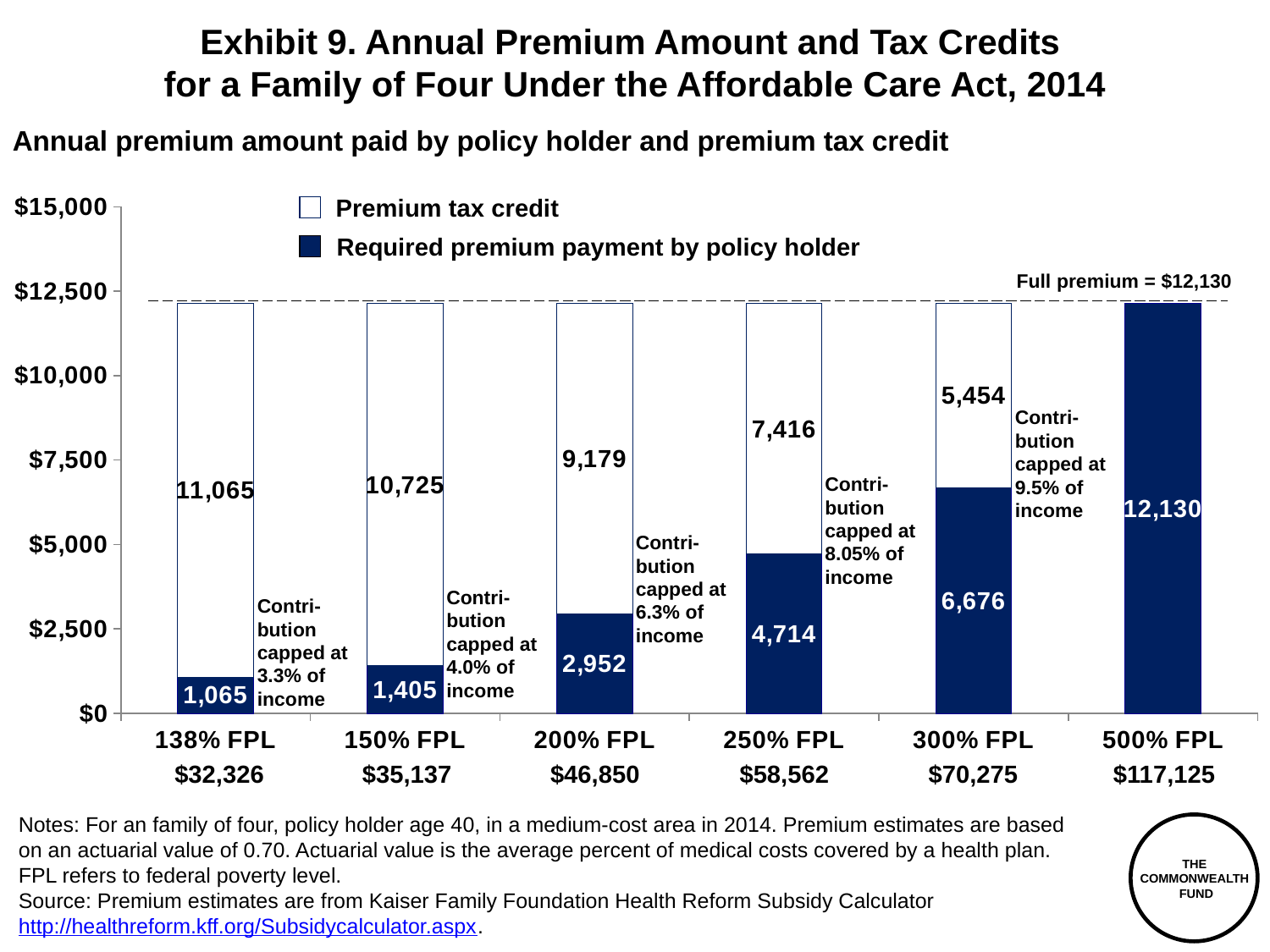
How many series does the legend list? 2 What is the required premium payment by policy holder at 138% FPL? 1,065 What is the total of the stacked bar at 300% FPL? 12,130 How many FPL categories are shown on the x axis? 6 Which FPL category has the highest premium tax credit? 138% FPL What kind of chart is shown on the slide? Stacked bar chart What is the difference between the premium tax credit at 150% FPL and at 250% FPL? 3,309 What is the required premium payment by policy holder at 300% FPL? 6,676 What is the premium tax credit at 200% FPL? 9,179 Which is larger: the required premium payment at 250% FPL or the premium tax credit at 250% FPL? Premium tax credit at 250% FPL Which FPL category has the lowest required premium payment by policy holder? 138% FPL Does the required premium payment by policy holder rise or fall as FPL increases along the x axis? Rise